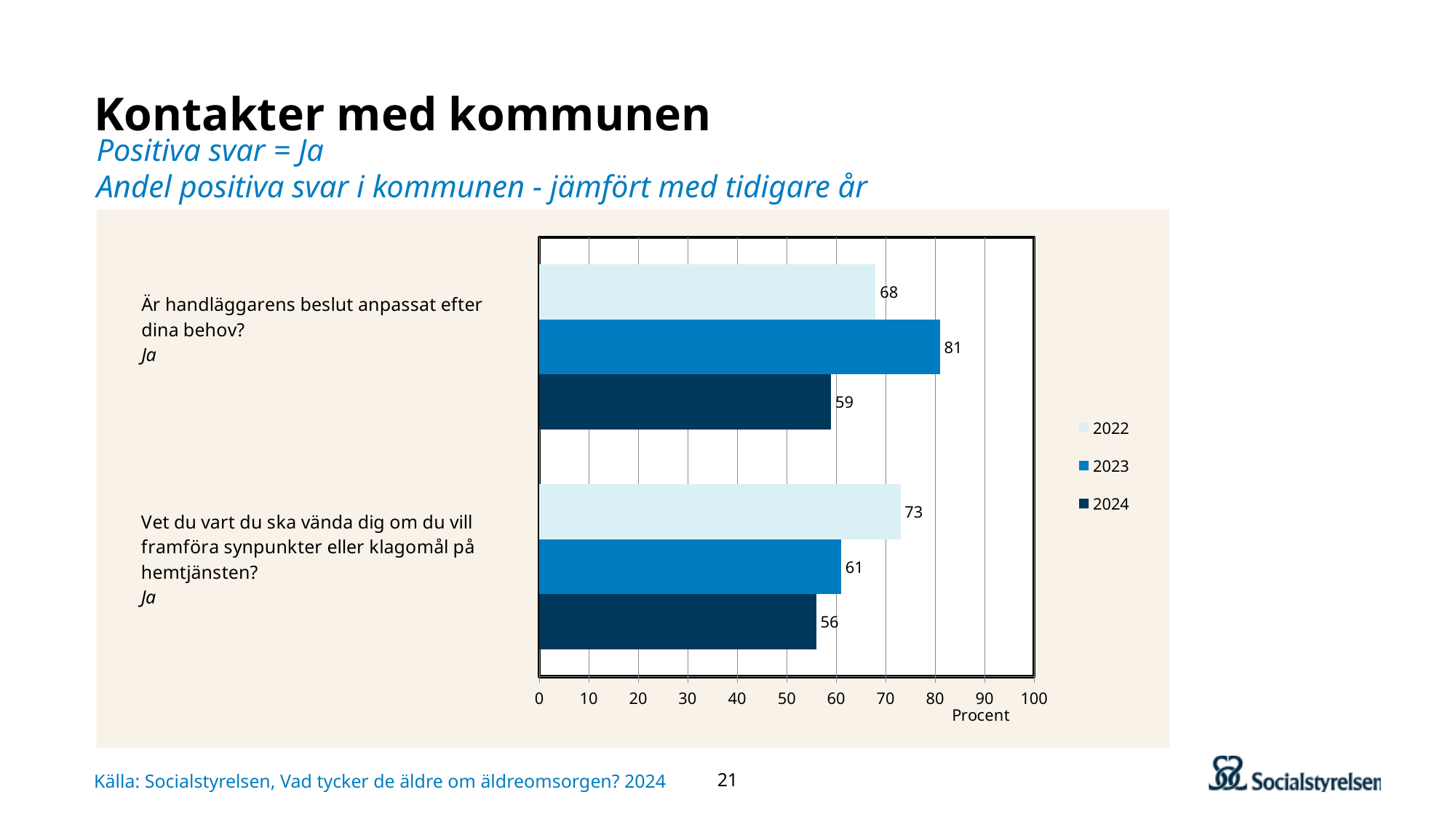
How many question categories are shown on the chart? 2 What is the 2024 value for "Vet du vart du ska vända dig om du vill framföra synpunkter eller klagomål på hemtjänsten?"? 56 What is the difference between the 2023 and 2024 values for "Är handläggarens beslut anpassat efter dina behov?"? 22 What kind of chart is shown on the slide? Bar chart How many series does the legend list? 3 What is the difference between the 2022 and 2023 values for "Vet du vart du ska vända dig om du vill framföra synpunkter eller klagomål på hemtjänsten?"? 12 Which is larger: the 2022 value for "Är handläggarens beslut anpassat efter dina behov?" or the 2022 value for "Vet du vart du ska vända dig om du vill framföra synpunkter eller klagomål på hemtjänsten?"? Vet du vart du ska vända dig om du vill framföra synpunkter eller klagomål på hemtjänsten? Which year has the highest value for "Är handläggarens beslut anpassat efter dina behov?"? 2023 What is the 2023 value for "Är handläggarens beslut anpassat efter dina behov?"? 81 What is the 2022 value for "Är handläggarens beslut anpassat efter dina behov?"? 68 What is the label of the horizontal axis? Procent Which year has the lowest value for "Vet du vart du ska vända dig om du vill framföra synpunkter eller klagomål på hemtjänsten?"? 2024